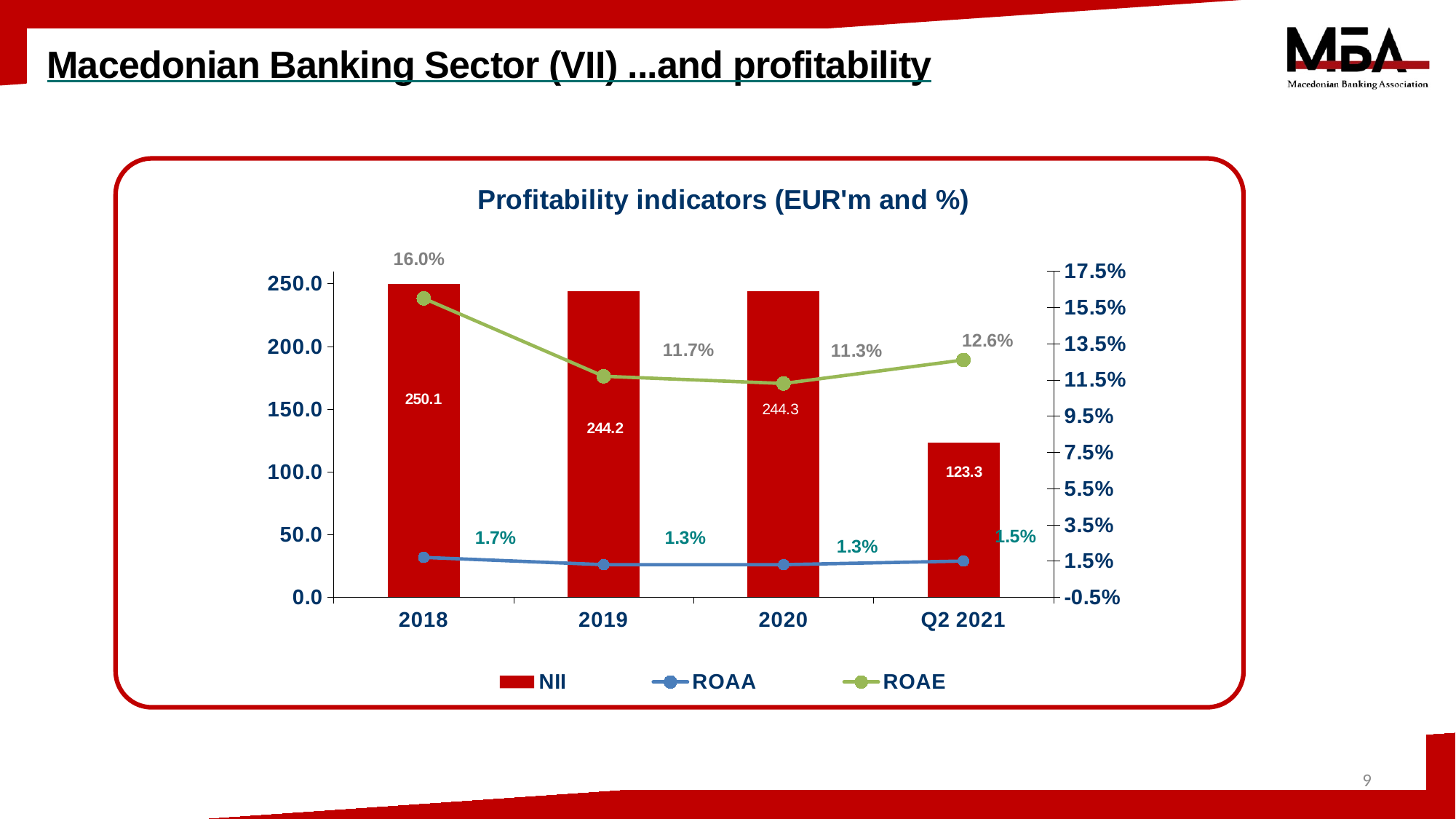
Is the ROAE for 2019 higher or lower than the ROAE for 2020? higher What is the difference between the NII values for 2018 and Q2 2021? 126.8 What is the ROAE value for 2018? 16.0% What is the NII value for 2018? 250.1 What is the ROAA value for 2019? 1.3% How many series does the legend list? 3 How many periods are shown on the x axis? 4 What is the ROAE value for Q2 2021? 12.6% Which period has the lowest NII? Q2 2021 Which period has the highest ROAE? 2018 What is the NII value for Q2 2021? 123.3 What is the title of the chart? Profitability indicators (EUR'm and %)